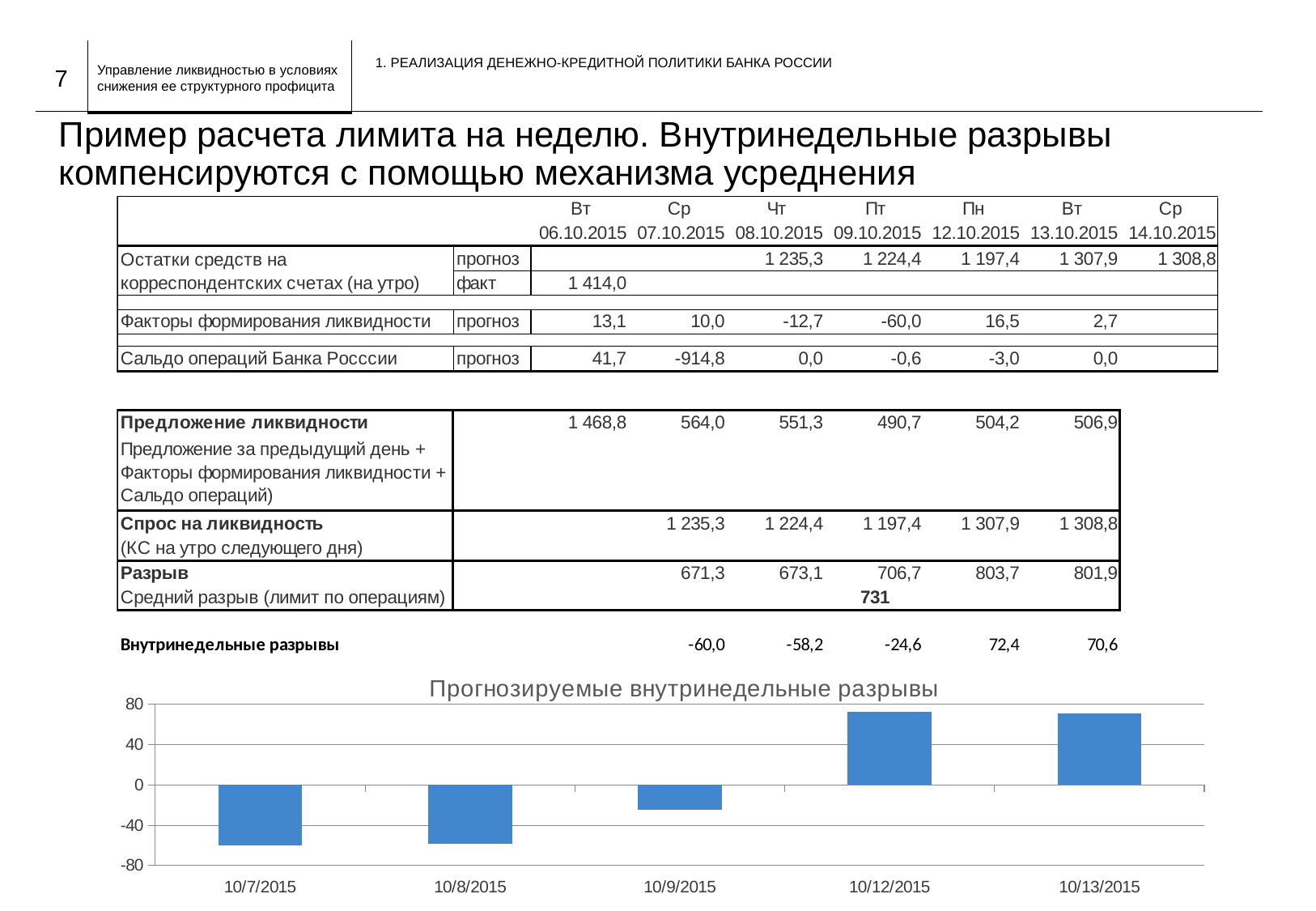
Is the value for 10/8/2015 greater or less than -40? less Do the values in the chart generally rise or fall from left to right along the x axis? rise Which is larger, the value for 10/9/2015 or the value for 10/8/2015? 10/9/2015 What is the title of the chart at the bottom of the slide? Прогнозируемые внутринедельные разрывы Is the value for 10/13/2015 greater or less than 40? greater Is the value for 10/12/2015 greater or less than 40? greater What kind of chart is shown at the bottom of the slide? bar chart How many bars in the chart are negative (below zero)? 3 How many dates are plotted on the x axis of the chart? 5 Which is larger, the value for 10/12/2015 or the value for 10/9/2015? 10/12/2015